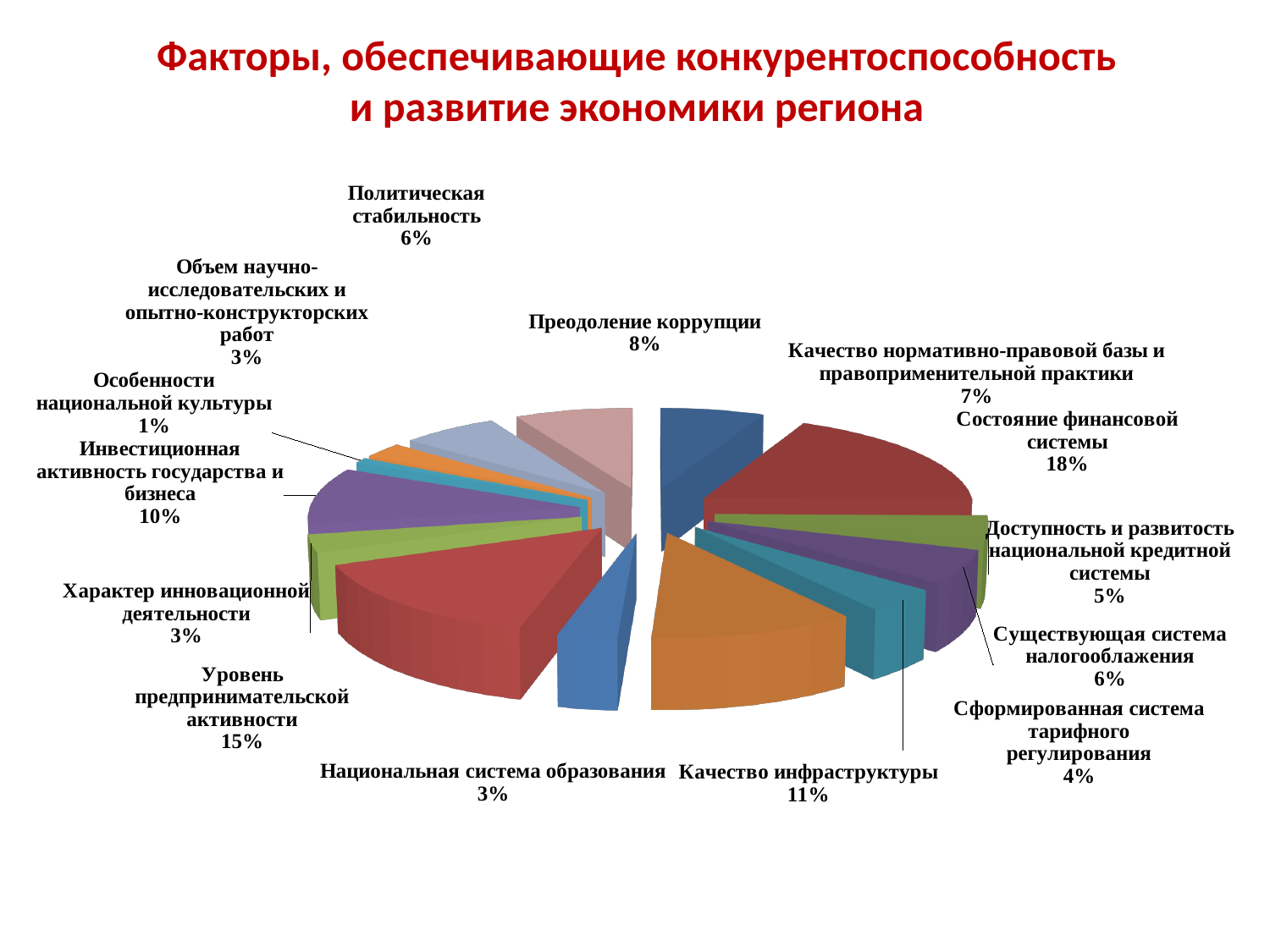
What is the title of the slide? Факторы, обеспечивающие конкурентоспособность и развитие экономики региона What share does "Сформированная система тарифного регулирования" have? 4% Which has a larger share: "Качество инфраструктуры" or "Инвестиционная активность государства и бизнеса"? Качество инфраструктуры Which category has the largest share in the pie chart? Состояние финансовой системы Which category has the smallest share in the pie chart? Особенности национальной культуры What share does "Качество инфраструктуры" have in the pie chart? 11% What share does "Состояние финансовой системы" have in the pie chart? 18% What kind of chart is shown on the slide? pie chart What share does "Преодоление коррупции" have in the pie chart? 8% What is the difference between the shares of "Состояние финансовой системы" and "Уровень предпринимательской активности"? 3% What share does "Инвестиционная активность государства и бизнеса" have? 10% How many categories are shown in the pie chart? 14